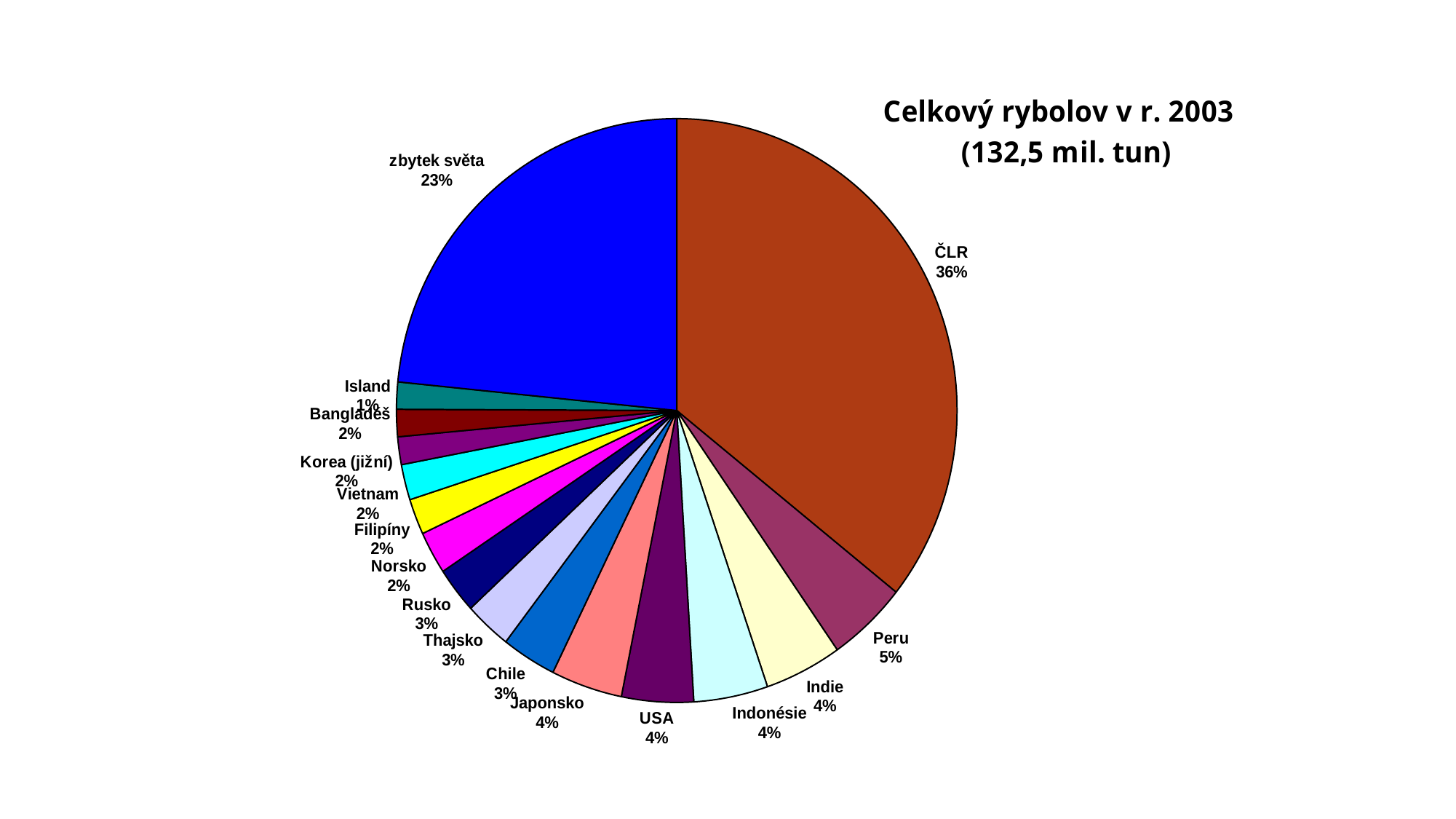
How many slices does the pie chart have? 16 What share of the pie does ČLR have? 36% What share of the pie does zbytek světa have? 23% What share of the pie does Peru have? 5% Which slice of the pie is the largest? ČLR Which is larger, the share for Peru or the share for Chile? Peru What kind of chart is shown on the slide? pie chart What is the difference in percentage points between ČLR and zbytek světa? 13 Which slice of the pie is the smallest? Island What is the title of the chart? Celkový rybolov v r. 2003 (132,5 mil. tun)